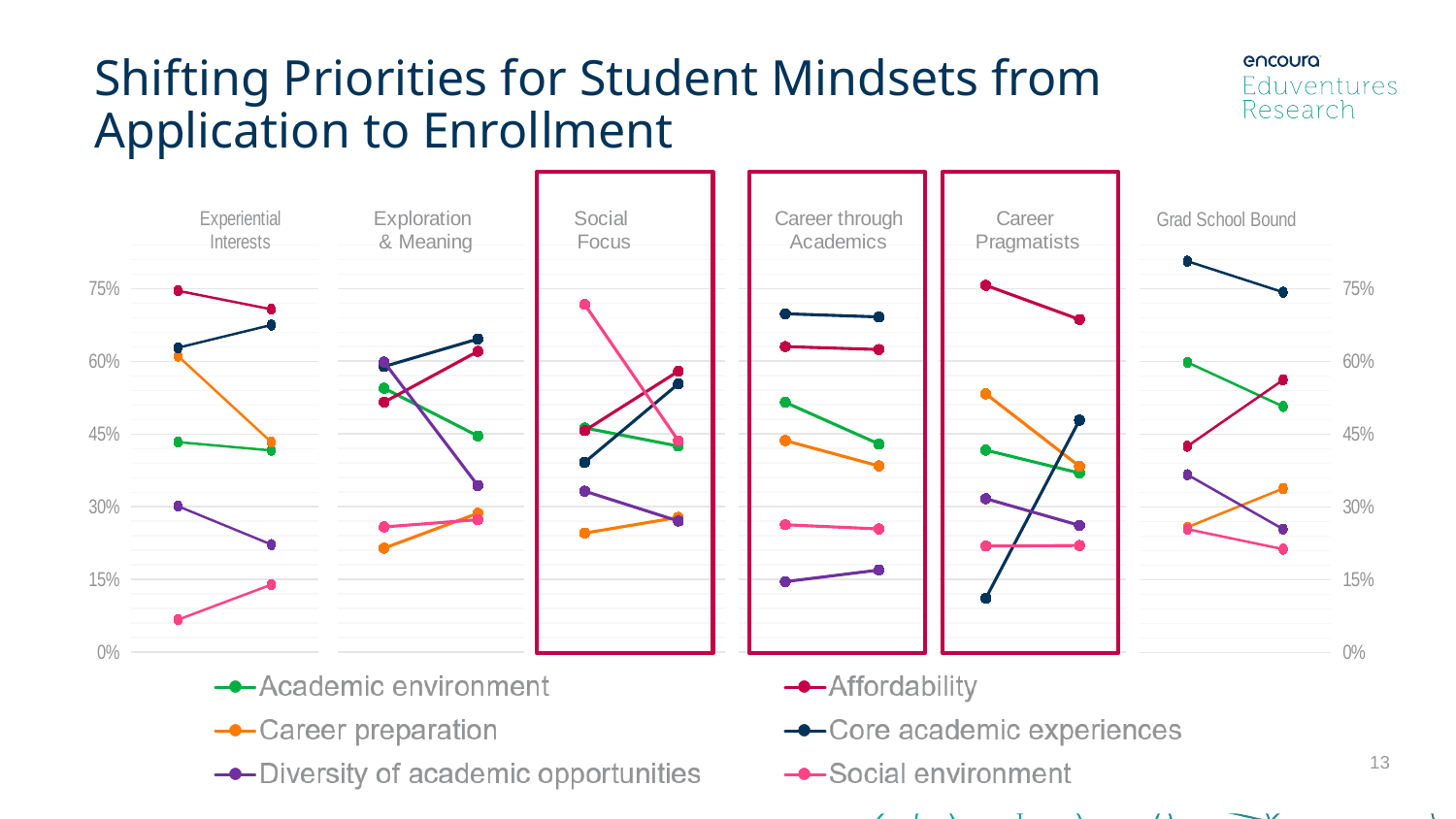
What kind of chart is used in each mindset panel? Line chart In the Experiential Interests panel, is the first value for Social environment greater or less than 15%? less In the Career Pragmatists panel, which series has the highest starting value? Affordability In the Social Focus panel, does the Social environment line rise or fall from application to enrollment? Falls How many series does the legend list? 6 Which three mindset panels are outlined with red boxes? Social Focus, Career through Academics, Career Pragmatists In the Career through Academics panel, which series has the lowest values? Diversity of academic opportunities In the Career Pragmatists panel, does the Core academic experiences line rise or fall from application to enrollment? Rises In the Grad School Bound panel, is the first value for Core academic experiences greater or less than 75%? greater In the Experiential Interests panel, does the Career preparation line rise or fall from application to enrollment? Falls In the Career through Academics panel, is the first value for Core academic experiences greater or less than 60%? greater How many student mindset panels are shown on the slide? 6